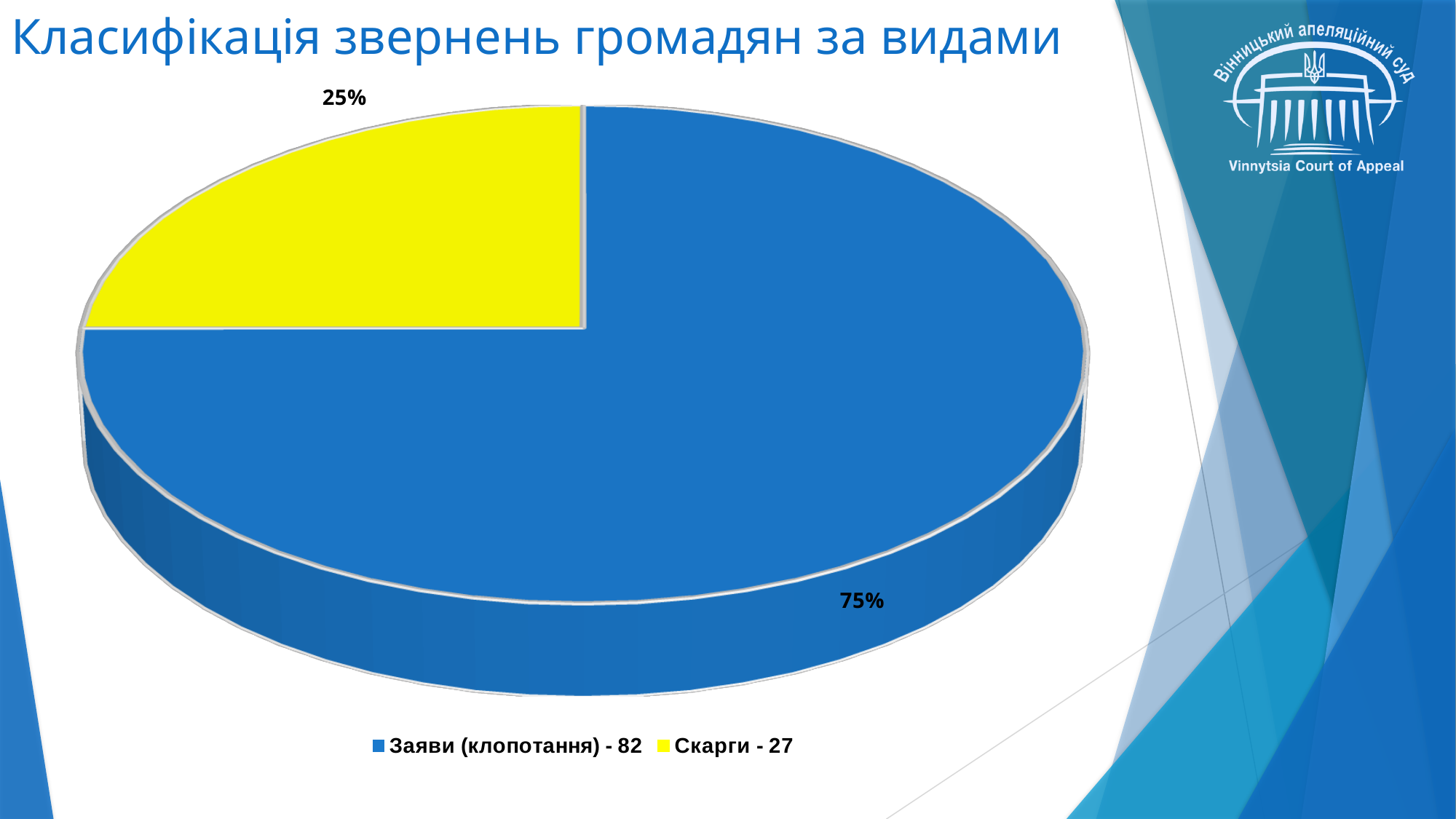
What kind of chart is shown on the slide? pie chart Which category has the smallest slice of the pie? Скарги - 27 How many entries does the legend list? 2 Which is larger, the share for "Заяви (клопотання)" or the share for "Скарги"? Заяви (клопотання) What colour is the "Скарги - 27" slice? yellow What is the difference in percentage points between the "Заяви (клопотання)" share and the "Скарги" share? 50 percentage points What share of the pie does the "Заяви (клопотання) - 82" slice represent? 75% What share of the pie does the "Скарги - 27" slice represent? 25% What is the title of the chart on the slide? Класифікація звернень громадян за видами Which category has the largest slice of the pie? Заяви (клопотання) - 82 How many slices does the pie chart have? 2